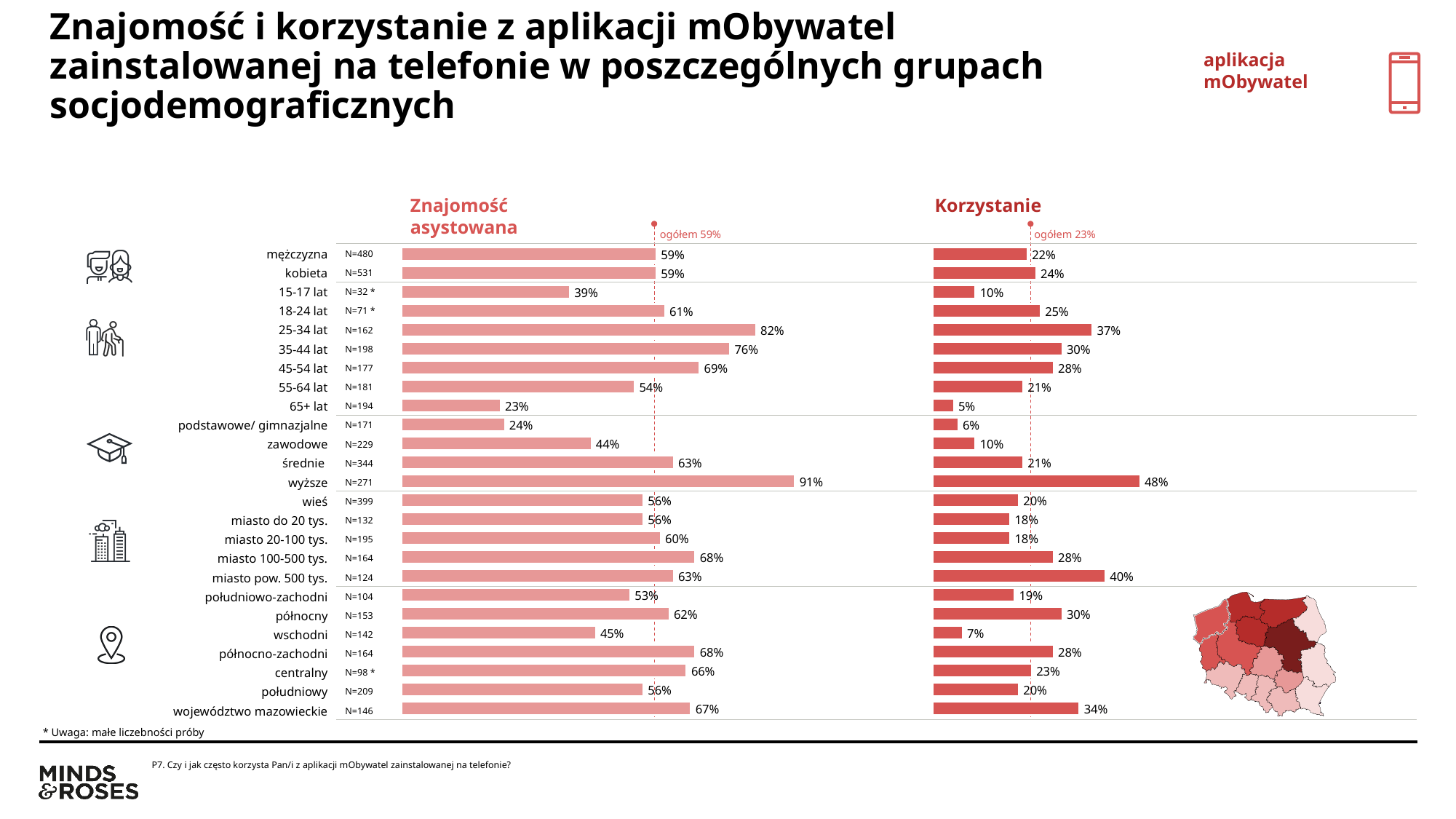
In the 'Korzystanie' chart, what is the difference between the values for wyższe and podstawowe/ gimnazjalne? 42% In the 'Znajomość asystowana' chart, what is the value for kobieta? 59% In the 'Korzystanie' chart, what is the value for województwo mazowieckie? 34% In the 'Znajomość asystowana' chart, which is larger: the value for północny or the value for wschodni? północny How many categories are plotted in the 'Korzystanie' chart? 25 In the 'Korzystanie' chart, which category has the lowest value? 65+ lat In the 'Znajomość asystowana' chart, what is the difference between the values for 18-24 lat and 15-17 lat? 22% In the 'Korzystanie' chart, what overall value ('ogółem') is marked by the dotted reference line? 23% In the 'Znajomość asystowana' chart, what is the value for 25-34 lat? 82% In the 'Korzystanie' chart, what is the value for miasto pow. 500 tys.? 40% In the 'Znajomość asystowana' chart, which category has the highest value? wyższe What kind of chart is the 'Znajomość asystowana' chart? bar chart